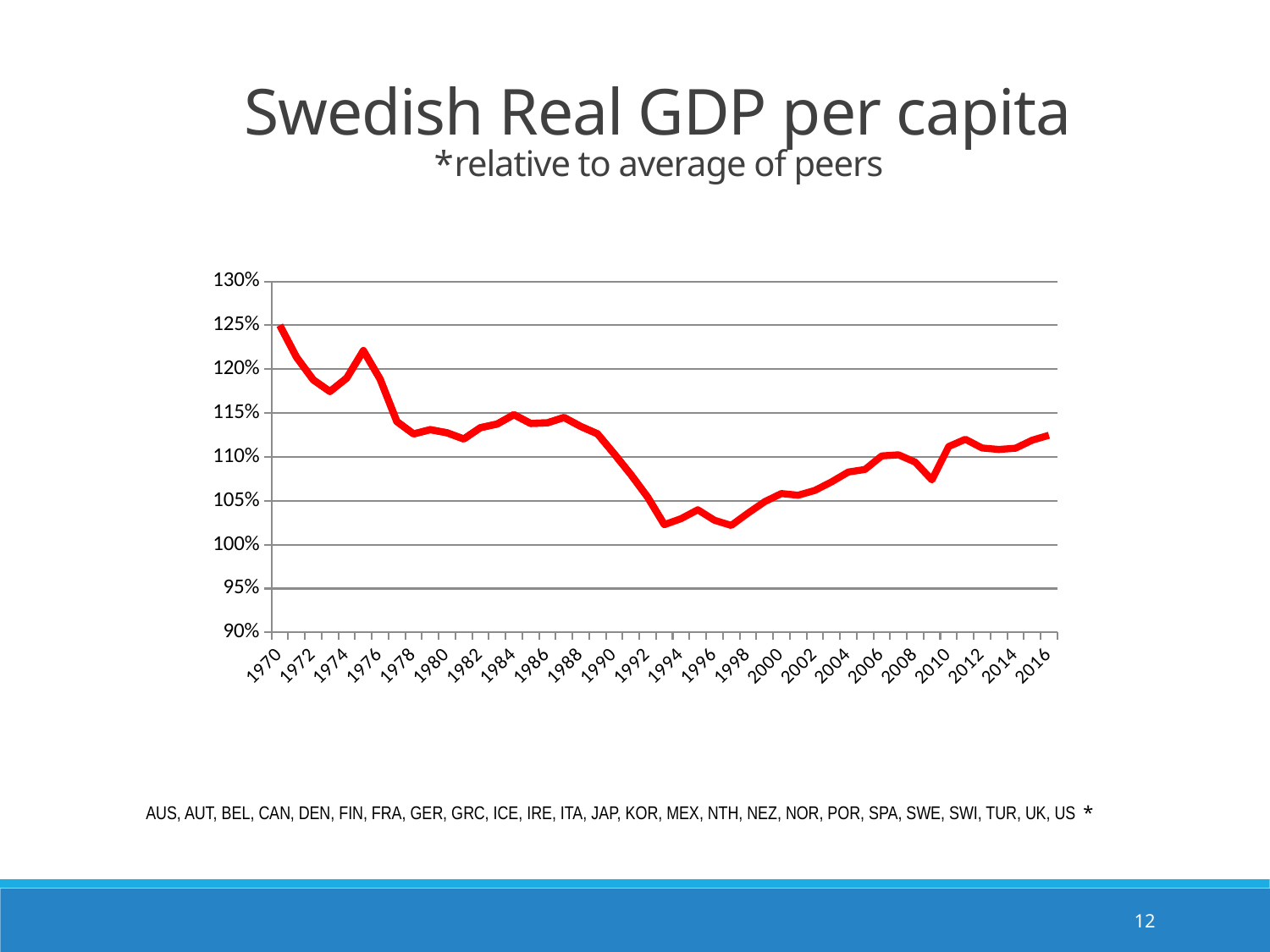
Is the value for 1970 greater or less than 120%? greater What is the title of the chart? Swedish Real GDP per capita What colour is the plotted line? red Is the value for 2009 greater or less than 110%? less Which year has the larger value, 1970 or 2016? 1970 Does the value rise or fall between 1970 and 1993? fall Is the value for 1993 greater or less than 105%? less Does the value rise or fall between 1997 and 2016? rise What kind of chart is shown on the slide? line chart Which year has the larger value, 1984 or 1993? 1984 In which year is Swedish real GDP per capita relative to peers at its highest? 1970